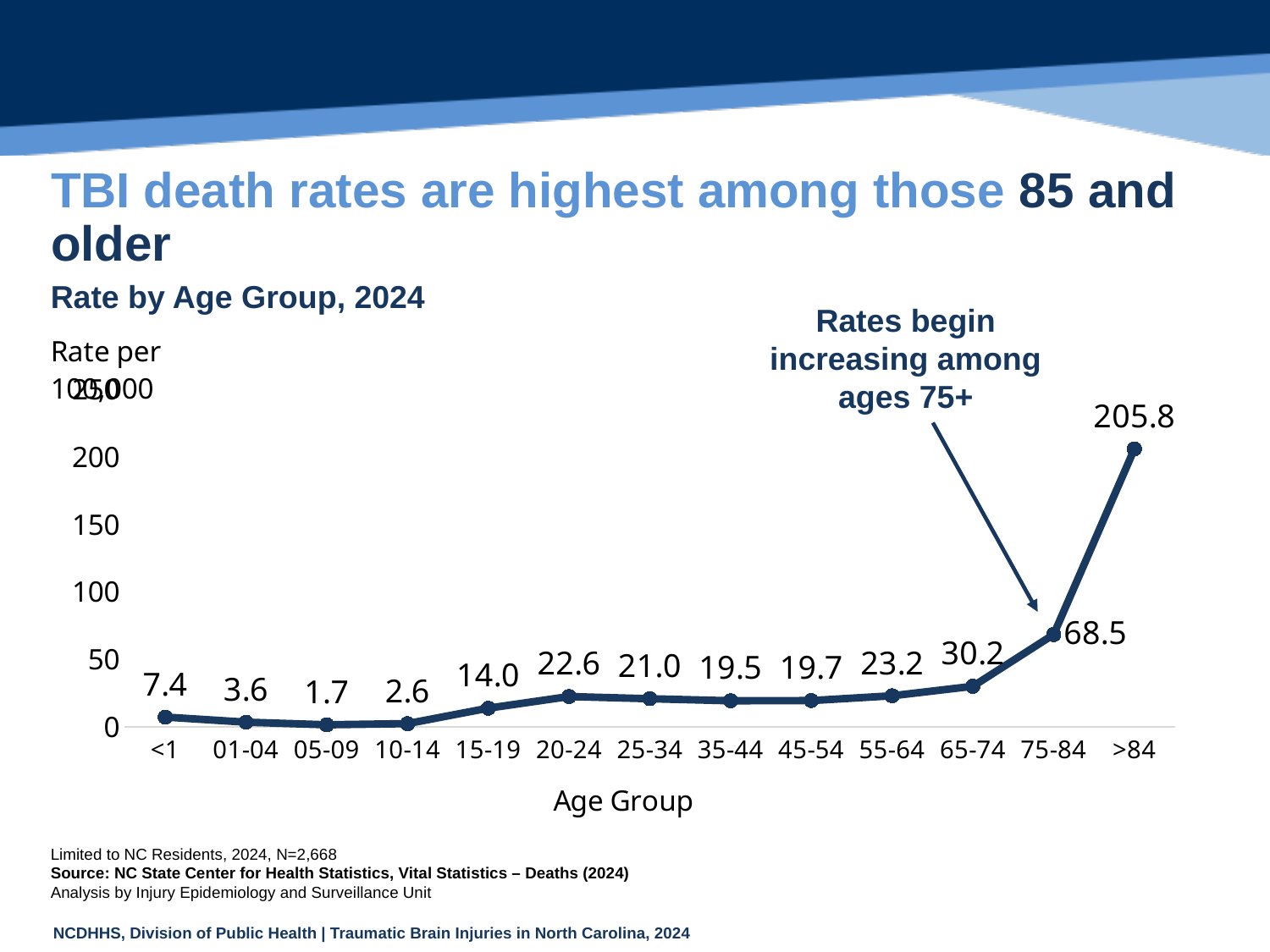
What kind of chart is shown on the slide? Line chart What is the difference between the TBI death rates for the 65-74 and 55-64 age groups? 7.0 Which age group has the highest TBI death rate? >84 What is the TBI death rate for the 75-84 age group? 68.5 What is the TBI death rate for the >84 age group? 205.8 What is the label of the x axis? Age Group What is the TBI death rate for the 20-24 age group? 22.6 Which age group has a higher TBI death rate, 15-19 or 65-74? 65-74 How many age groups are plotted on the chart? 13 Which age group has the lowest TBI death rate? 05-09 What is the TBI death rate for the <1 age group? 7.4 What is the difference between the TBI death rates for the >84 and 75-84 age groups? 137.3